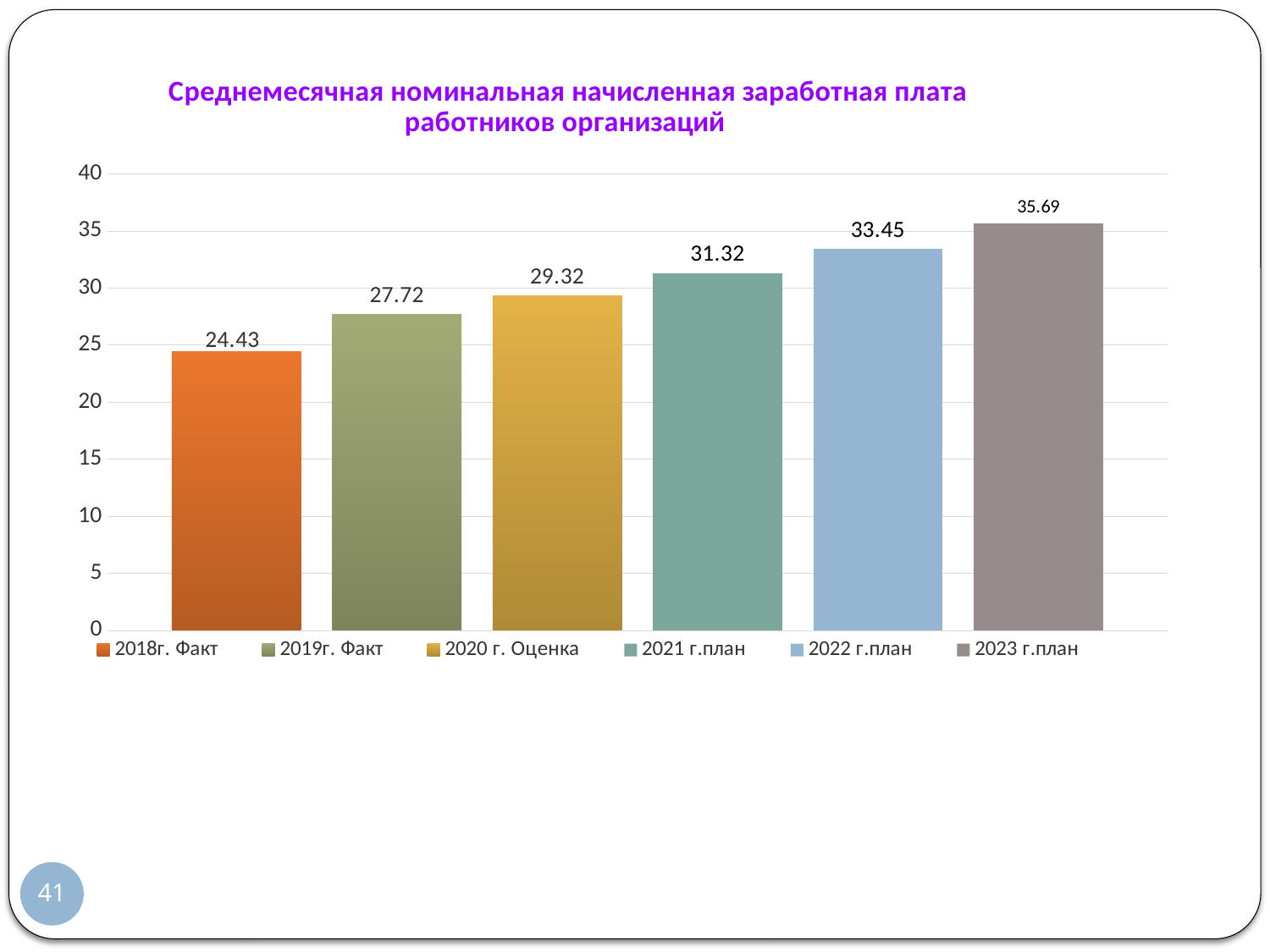
What is the value for 2018г. Факт? 24.43 Do the values rise or fall from 2018г. Факт to 2023 г.план? rise What is the value for 2020 г. Оценка? 29.32 Which category has the lowest value? 2018г. Факт Which is larger, the value for 2019г. Факт or the value for 2021 г.план? 2021 г.план What is the value for 2022 г.план? 33.45 Is the value for 2022 г.план greater or less than 30? greater What is the difference between the values for 2021 г.план and 2019г. Факт? 3.6 How many bars are shown in the chart? 6 Which category has the highest value? 2023 г.план What kind of chart is shown on the slide? bar chart What is the difference between the values for 2023 г.план and 2018г. Факт? 11.26